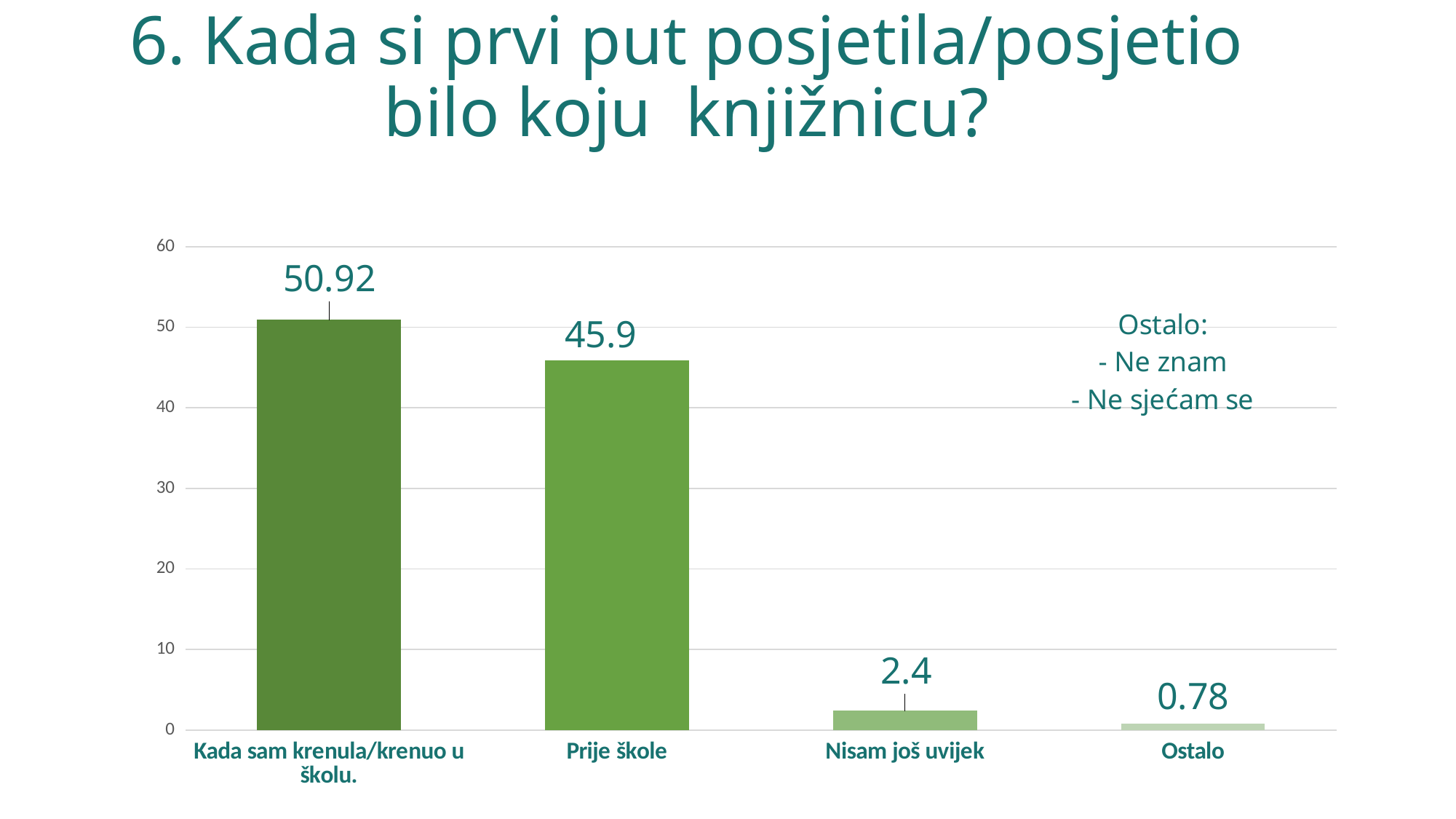
What is the value for "Prije škole"? 45.9 How many categories are shown on the x axis? 4 Which category has the lowest value? Ostalo What is the value for "Nisam još uvijek"? 2.4 What two answers are listed under "Ostalo:" in the text box on the chart? Ne znam; Ne sjećam se What is the value for "Kada sam krenula/krenuo u školu."? 50.92 What is the value for "Ostalo"? 0.78 What kind of chart is shown on the slide? bar chart Which is larger, the value for "Nisam još uvijek" or the value for "Ostalo"? Nisam još uvijek Which category has the highest value? Kada sam krenula/krenuo u školu. What is the difference between the values for "Kada sam krenula/krenuo u školu." and "Prije škole"? 5.02 Is the value for "Prije škole" greater or less than 50? less